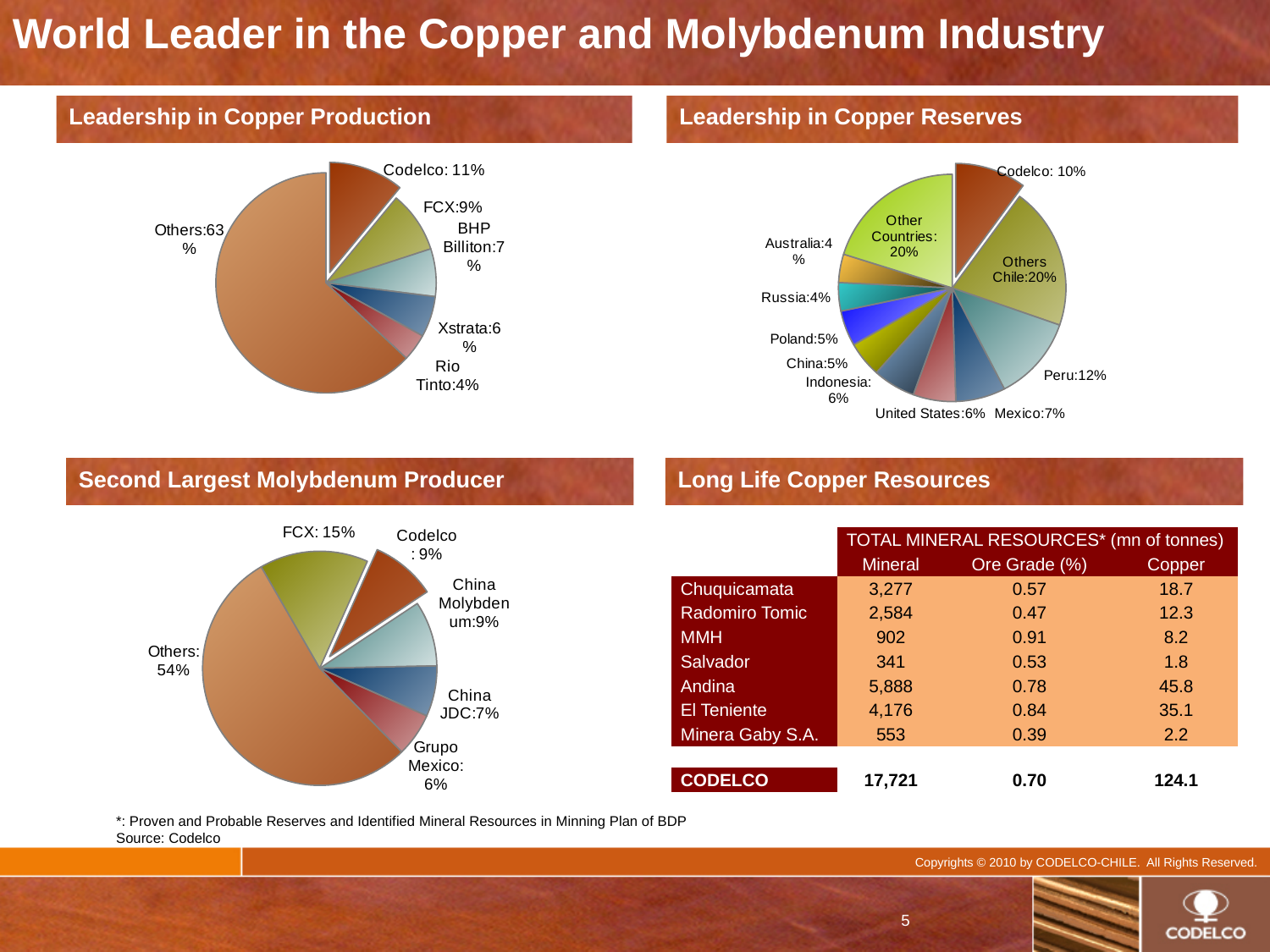
In the 'Leadership in Copper Reserves' chart, which is larger, the share for Mexico or the share for Poland? Mexico In the 'Second Largest Molybdenum Producer' chart, what is the difference between the China JDC share and the Grupo Mexico share? 1% In the 'Leadership in Copper Reserves' chart, what share is shown for Peru? 12% In the 'Leadership in Copper Production' chart, what share does Codelco hold? 11% What type of chart is used under 'Second Largest Molybdenum Producer'? Pie chart In the 'Second Largest Molybdenum Producer' chart, which slice is the largest? Others In the 'Leadership in Copper Reserves' chart, what is the difference between the Others Chile share and the Codelco share? 10% In the 'Leadership in Copper Production' chart, how many slices does the pie have? 6 In the 'Leadership in Copper Production' chart, which named company has the smallest slice? Rio Tinto In the 'Leadership in Copper Production' chart, what is the difference between the FCX share and the Xstrata share? 3% In the 'Second Largest Molybdenum Producer' chart, what share is shown for FCX? 15% In the 'Leadership in Copper Reserves' chart, how many slices does the pie have? 11